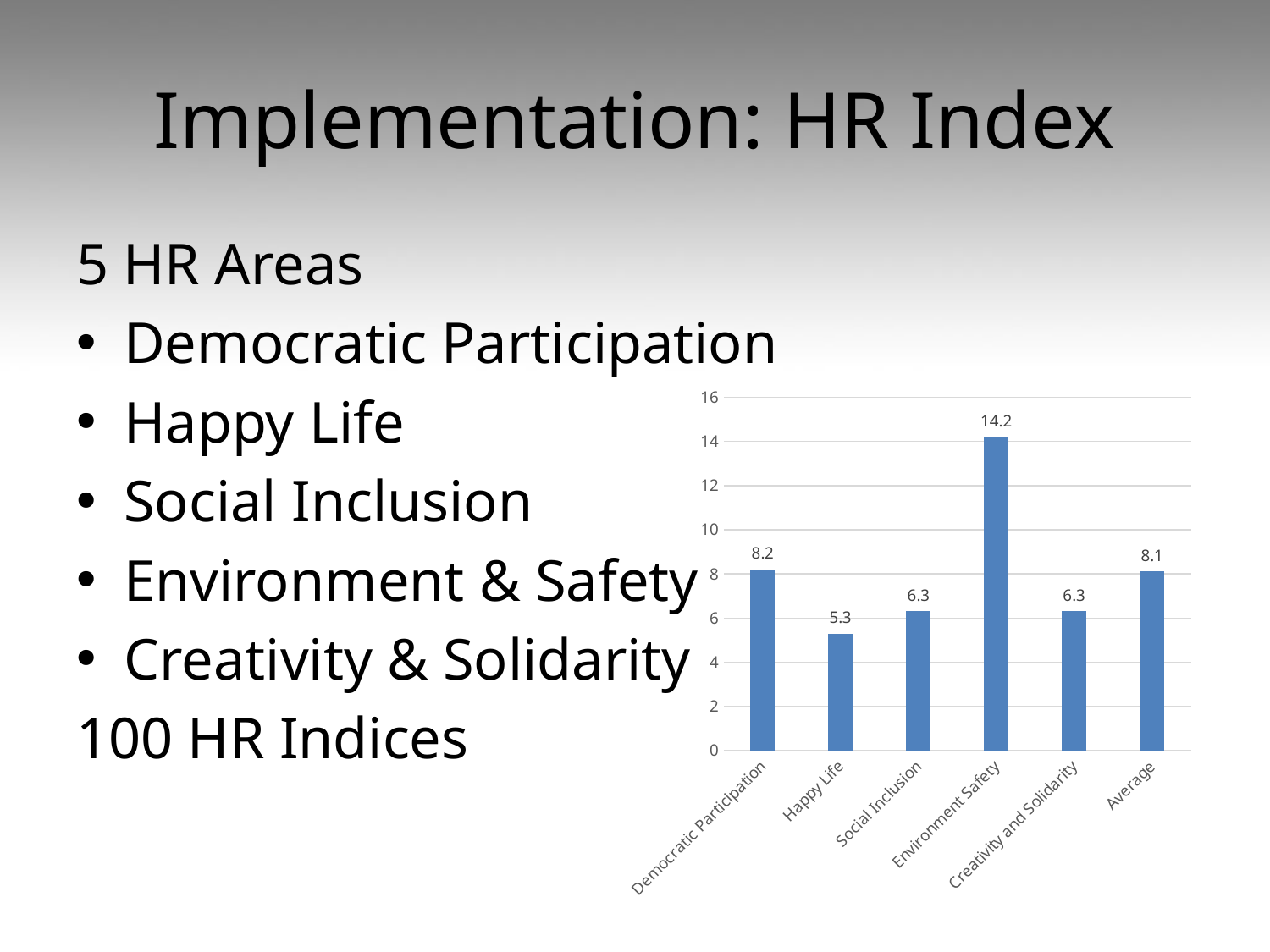
Is the value for Creativity and Solidarity greater or less than 8? less Which category has the lowest value? Happy Life Which category has the highest value? Environment Safety What is the value for Democratic Participation? 8.2 What is the value for Happy Life? 5.3 What is the highest value labelled on the y axis? 16 What is the difference between the values for Environment Safety and Happy Life? 8.9 What is the value shown for Average? 8.1 Which is larger, the value for Democratic Participation or the value for Social Inclusion? Democratic Participation What kind of chart is shown on the slide? bar chart How many categories are shown on the x axis? 6 What is the value for Environment Safety? 14.2